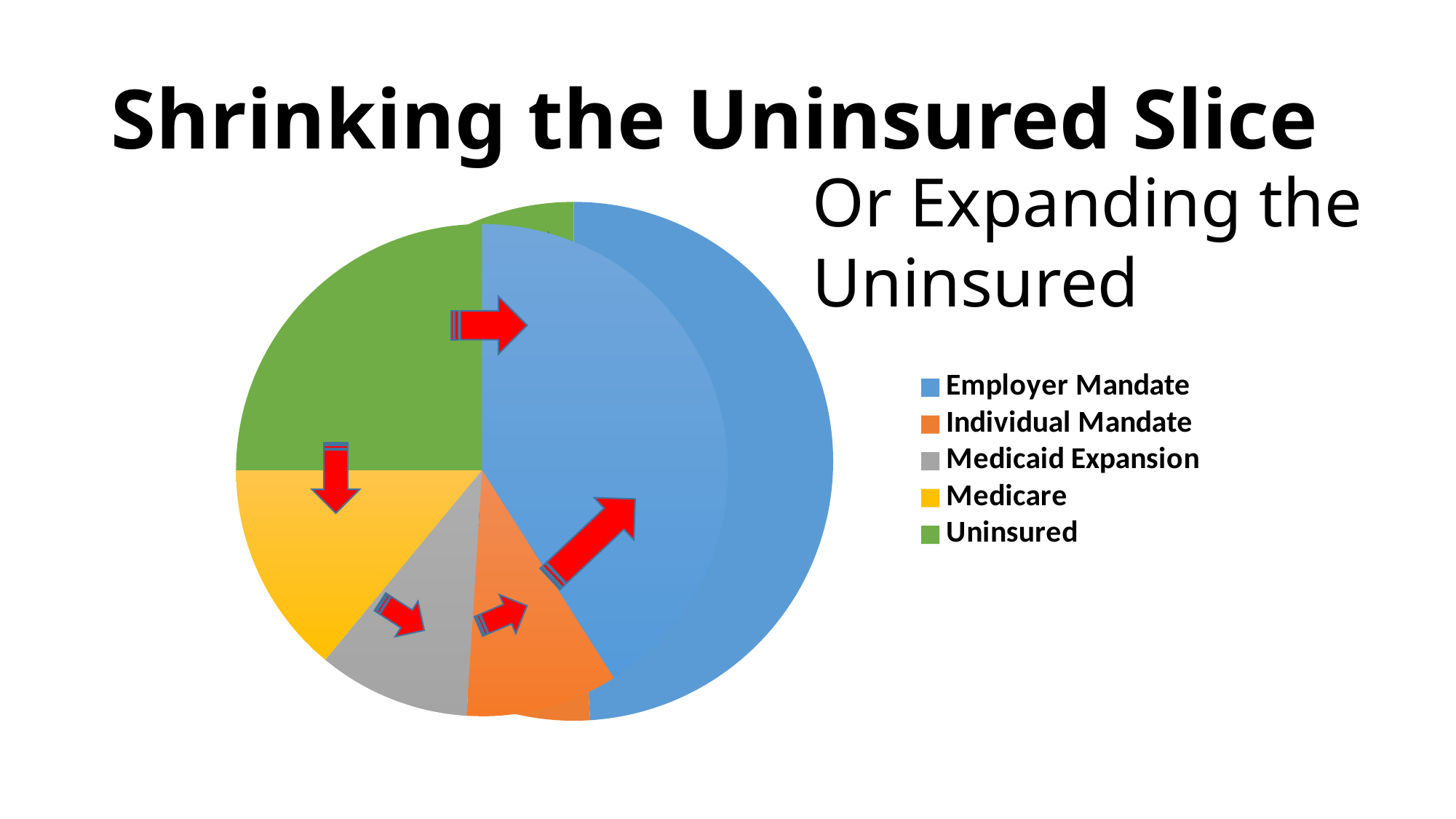
How many slices does the pie chart have? 5 What colour represents the Uninsured category in the pie chart? Green What kind of chart is shown on the slide? Pie chart How many categories does the legend of the pie chart list? 5 What is the title of the slide containing the pie chart? Shrinking the Uninsured Slice Which slice is larger in the pie chart, Employer Mandate or Individual Mandate? Employer Mandate Which category has the largest slice in the pie chart? Employer Mandate Which slice is larger in the pie chart, Employer Mandate or Uninsured? Employer Mandate